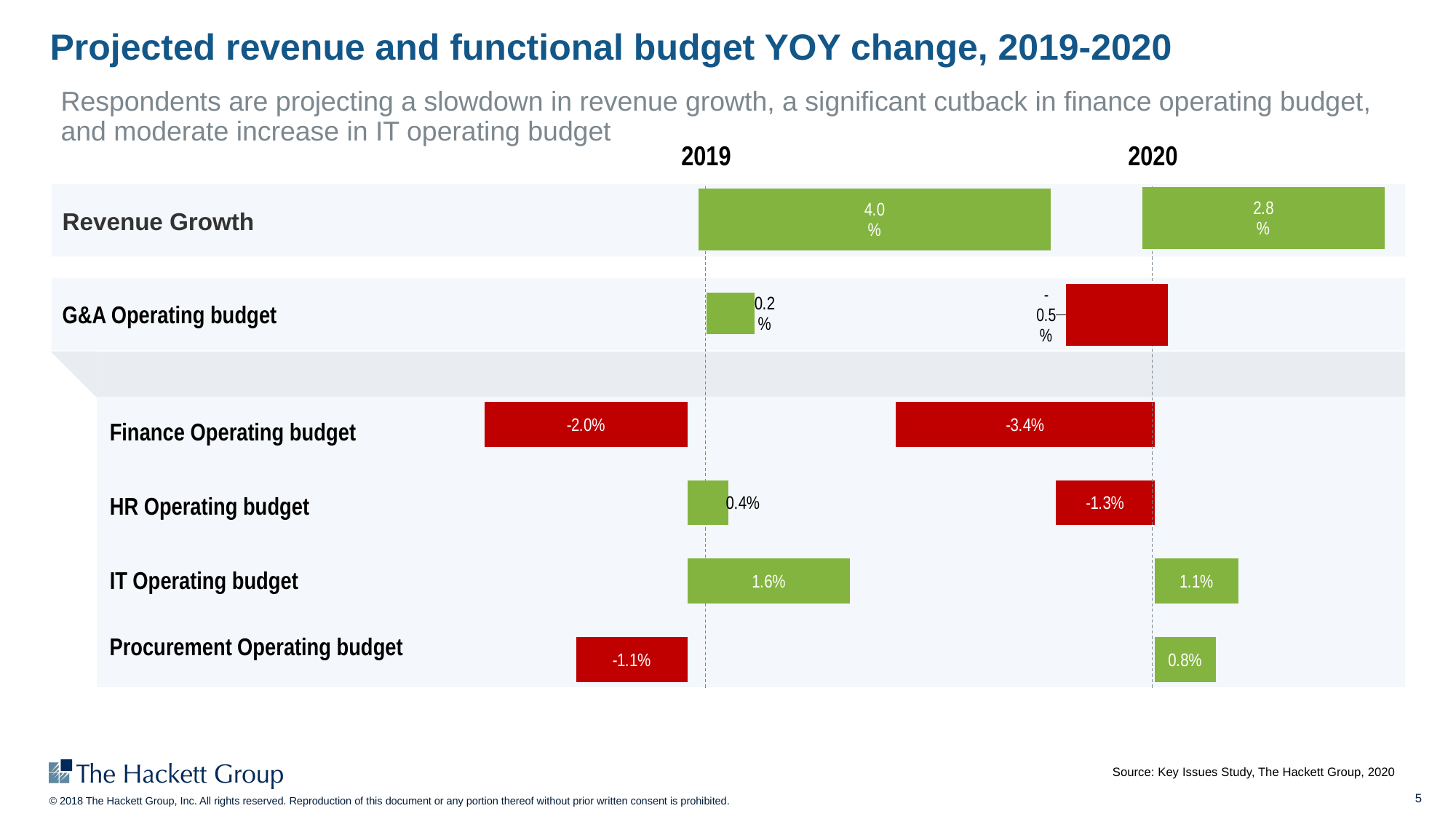
What is the 2020 YOY change for the Procurement Operating budget? 0.8% Which category has the lowest value in 2020? Finance Operating budget What is the projected revenue growth for 2020? 2.8% What is the 2020 YOY change for the Finance Operating budget? -3.4% Which category has the highest value in 2019? Revenue Growth Which is larger, the 2019 IT Operating budget change or the 2020 IT Operating budget change? 2019 (1.6%) What is the projected revenue growth for 2019? 4.0% By how many percentage points does projected revenue growth fall from 2019 to 2020? 1.2 percentage points What is the 2020 YOY change for the HR Operating budget? -1.3% What colour are the bars for negative values? Red What is the 2019 YOY change for the IT Operating budget? 1.6% How many categories are shown in the chart? 6